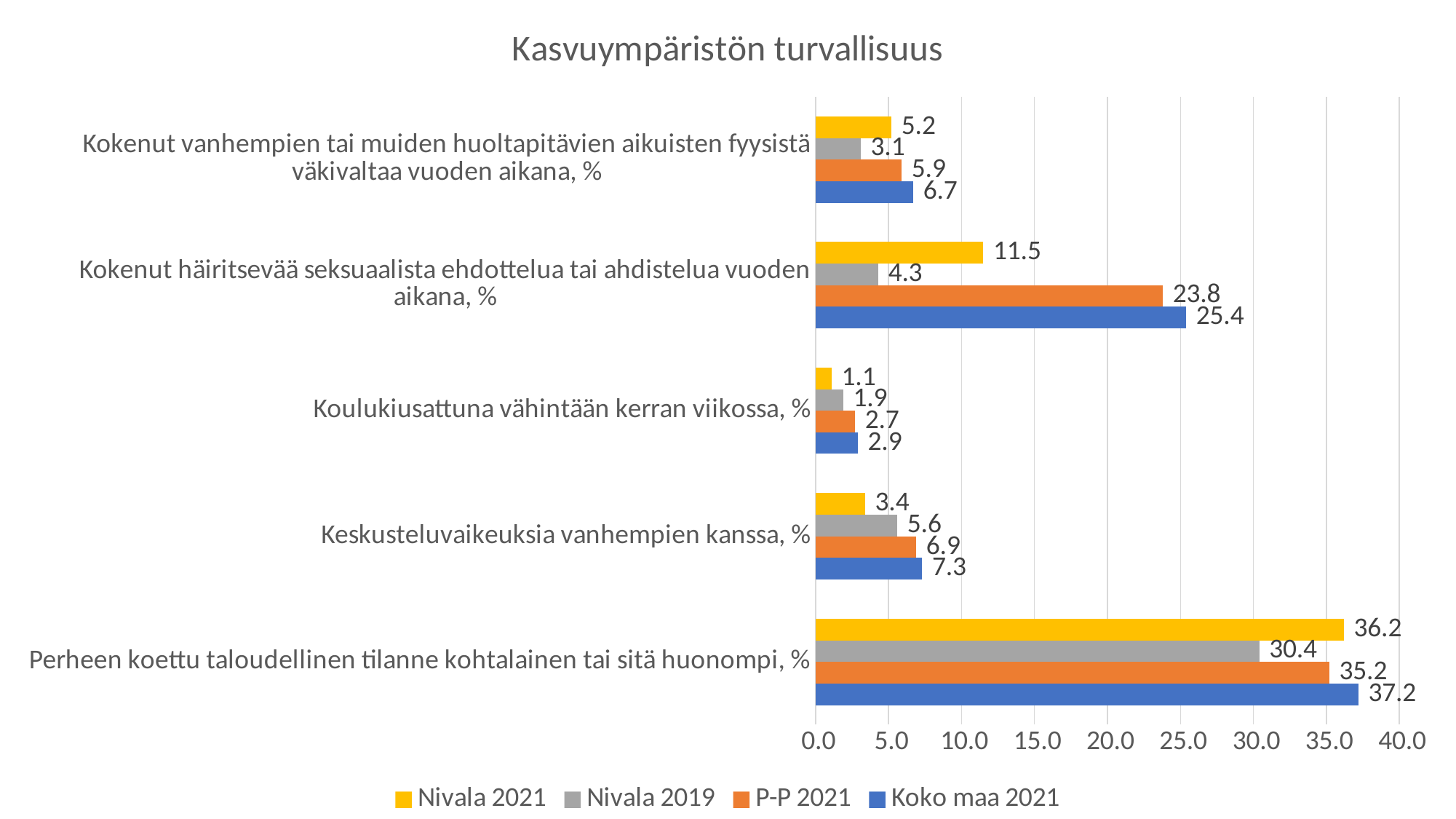
Which series has the highest value in the category "Perheen koettu taloudellinen tilanne kohtalainen tai sitä huonompi, %"? Koko maa 2021 How many series does the legend list? 4 Is the value for P-P 2021 in the category "Perheen koettu taloudellinen tilanne kohtalainen tai sitä huonompi, %" greater or less than 30.0? greater What is the value for P-P 2021 in the category "Keskusteluvaikeuksia vanhempien kanssa, %"? 6.9 How many categories are shown on the chart? 5 Which series has the lowest value in the category "Kokenut vanhempien tai muiden huoltapitävien aikuisten fyysistä väkivaltaa vuoden aikana, %"? Nivala 2019 What is the difference between Koko maa 2021 and Nivala 2021 in the category "Kokenut häiritsevää seksuaalista ehdottelua tai ahdistelua vuoden aikana, %"? 13.9 What is the value for Nivala 2021 in the category "Koulukiusattuna vähintään kerran viikossa, %"? 1.1 What type of chart is shown on the slide? Bar chart What is the value for Nivala 2019 in the category "Perheen koettu taloudellinen tilanne kohtalainen tai sitä huonompi, %"? 30.4 Which is larger in the category "Keskusteluvaikeuksia vanhempien kanssa, %": Nivala 2021 or Nivala 2019? Nivala 2019 What is the value for Koko maa 2021 in the category "Kokenut häiritsevää seksuaalista ehdottelua tai ahdistelua vuoden aikana, %"? 25.4